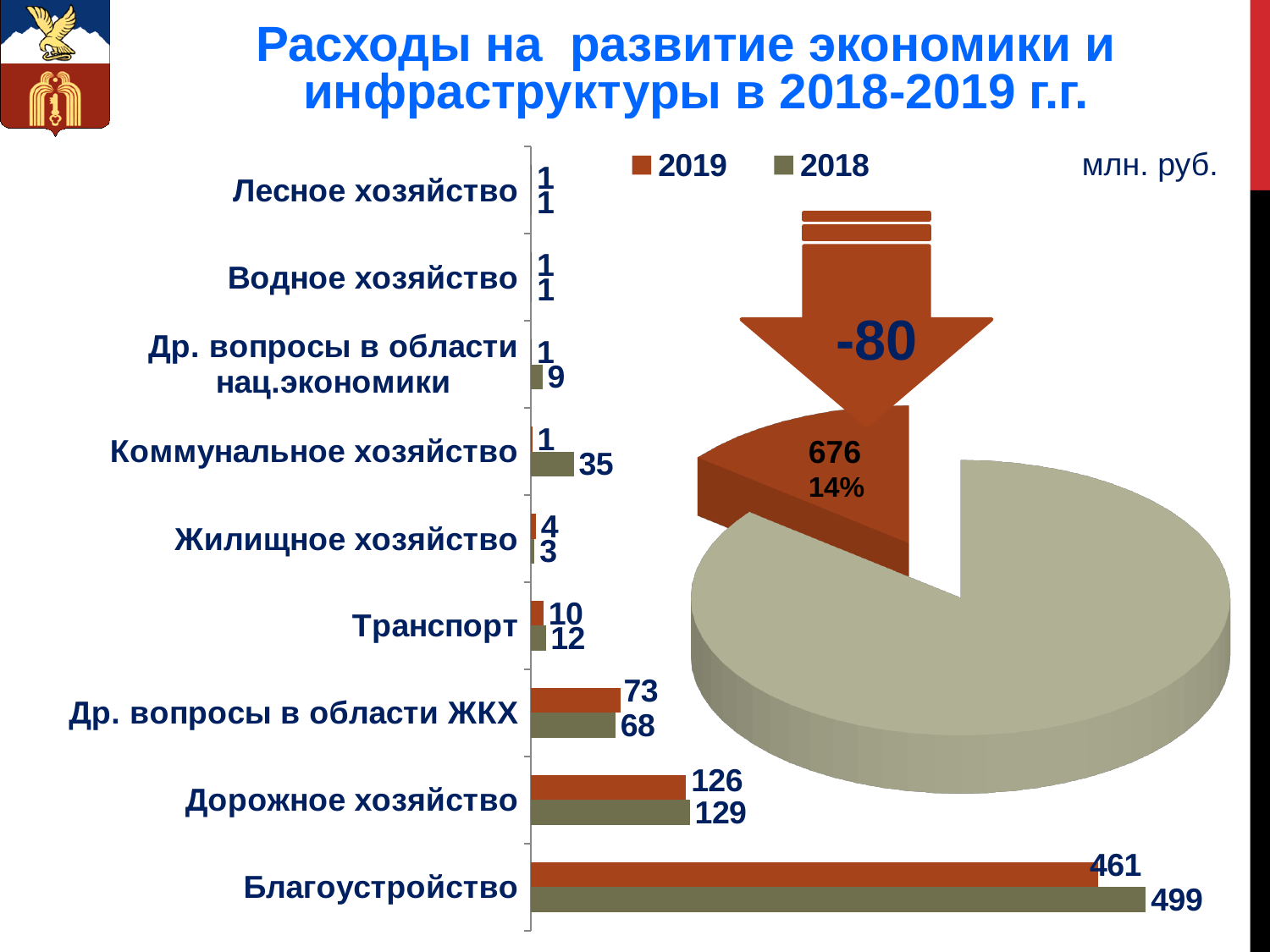
On the bar chart, what is the 2018 value for Дорожное хозяйство? 129 On the pie chart, what share is shown for the slice labelled 676? 14% On the bar chart, which is larger for Др. вопросы в области ЖКХ: the 2019 value or the 2018 value? 2019 On the bar chart, what is the difference between the 2018 and 2019 values for Коммунальное хозяйство? 34 On the bar chart, what is the difference between the 2018 and 2019 values for Благоустройство? 38 How many categories does the bar chart show? 9 On the bar chart, what is the 2019 value for Благоустройство? 461 How many series does the bar chart legend list? 2 On the bar chart, which is larger for Транспорт: the 2019 value or the 2018 value? 2018 What kind of chart is the chart on the left side of the slide? Bar chart On the bar chart, which category has the highest 2018 value? Благоустройство On the bar chart, what is the 2018 value for Коммунальное хозяйство? 35